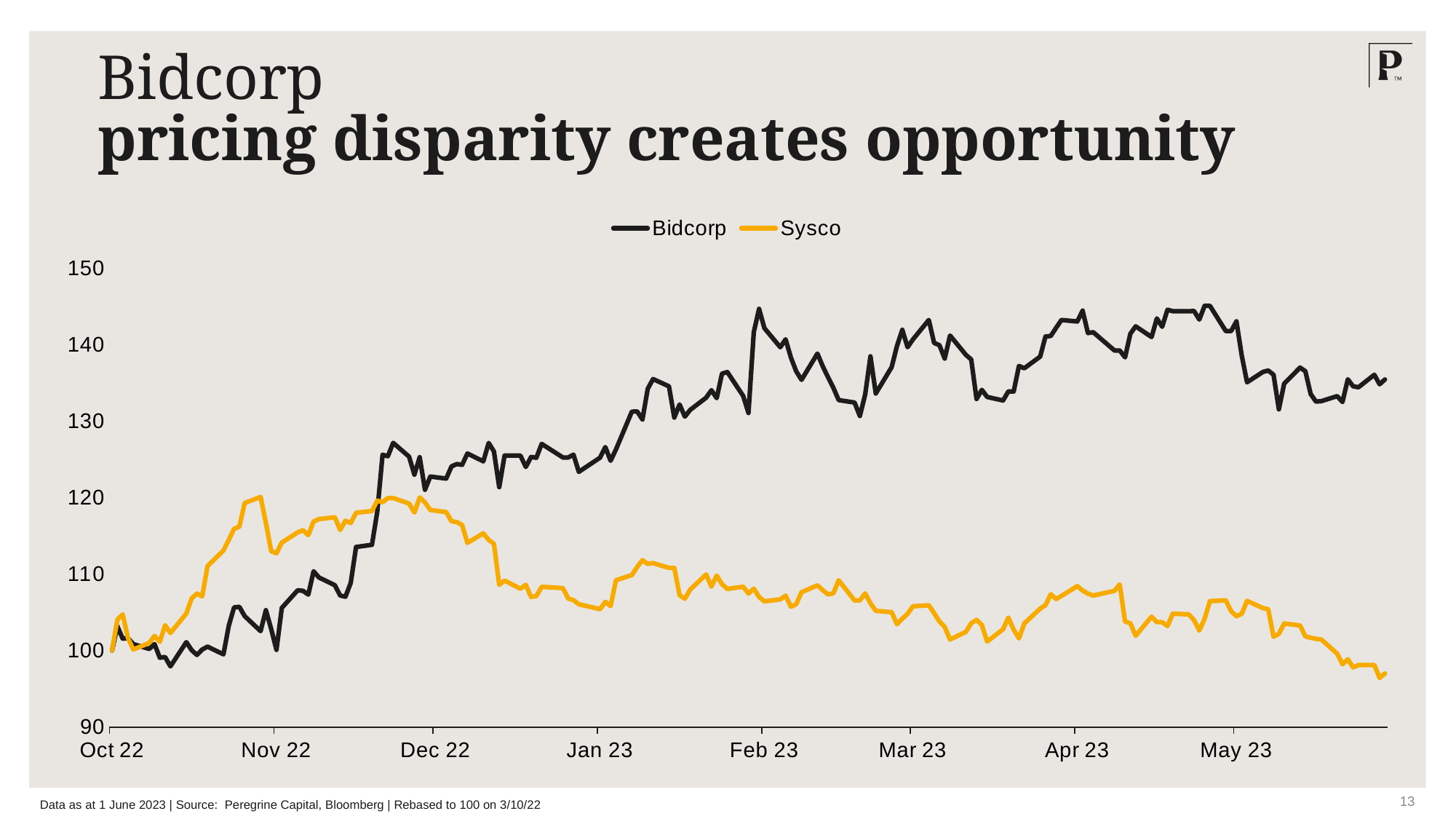
At the end of the chart, which series is higher, Bidcorp or Sysco? Bidcorp Is the value for Sysco at the end of the chart (late May 23) greater or less than 100? less Is the value for Bidcorp at the end of the chart (late May 23) greater or less than 130? greater Is the value for Sysco at Mar 23 greater or less than 110? less To what value are both series rebased at the start of the chart? 100 Around Nov 22, which series is higher, Bidcorp or Sysco? Sysco What colour is the Sysco line? Yellow Which two series are plotted in the chart? Bidcorp and Sysco How many series does the legend list? 2 How many month labels are shown on the x axis? 8 What kind of chart is shown on the slide? Line chart